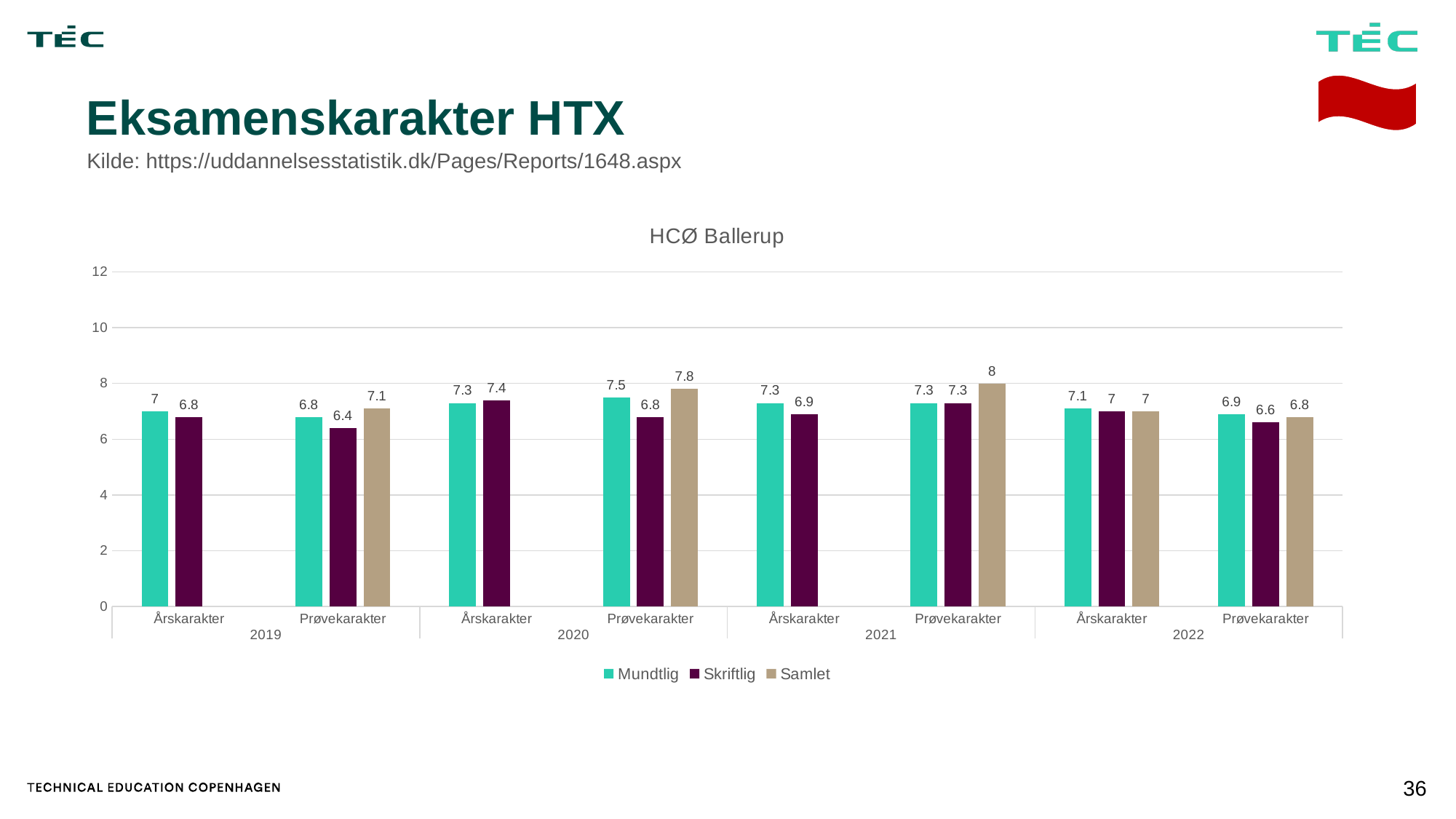
How many series does the legend list? 3 What is the Skriftlig value for Prøvekarakter in 2019? 6.4 What kind of chart is shown? Bar chart Which category group has the lowest Skriftlig value? Prøvekarakter 2019 What is the title of the chart? HCØ Ballerup What is the Samlet value for Prøvekarakter in 2021? 8 Which is larger for Årskarakter in 2020: the Mundtlig value or the Skriftlig value? Skriftlig What is the Mundtlig value for Prøvekarakter in 2020? 7.5 Is the Samlet value for Prøvekarakter in 2021 greater or less than 6? greater What is the Samlet value for Prøvekarakter in 2022? 6.8 Which category group has the highest Samlet value? Prøvekarakter 2021 What is the difference between the Samlet and Skriftlig values for Prøvekarakter in 2020? 1